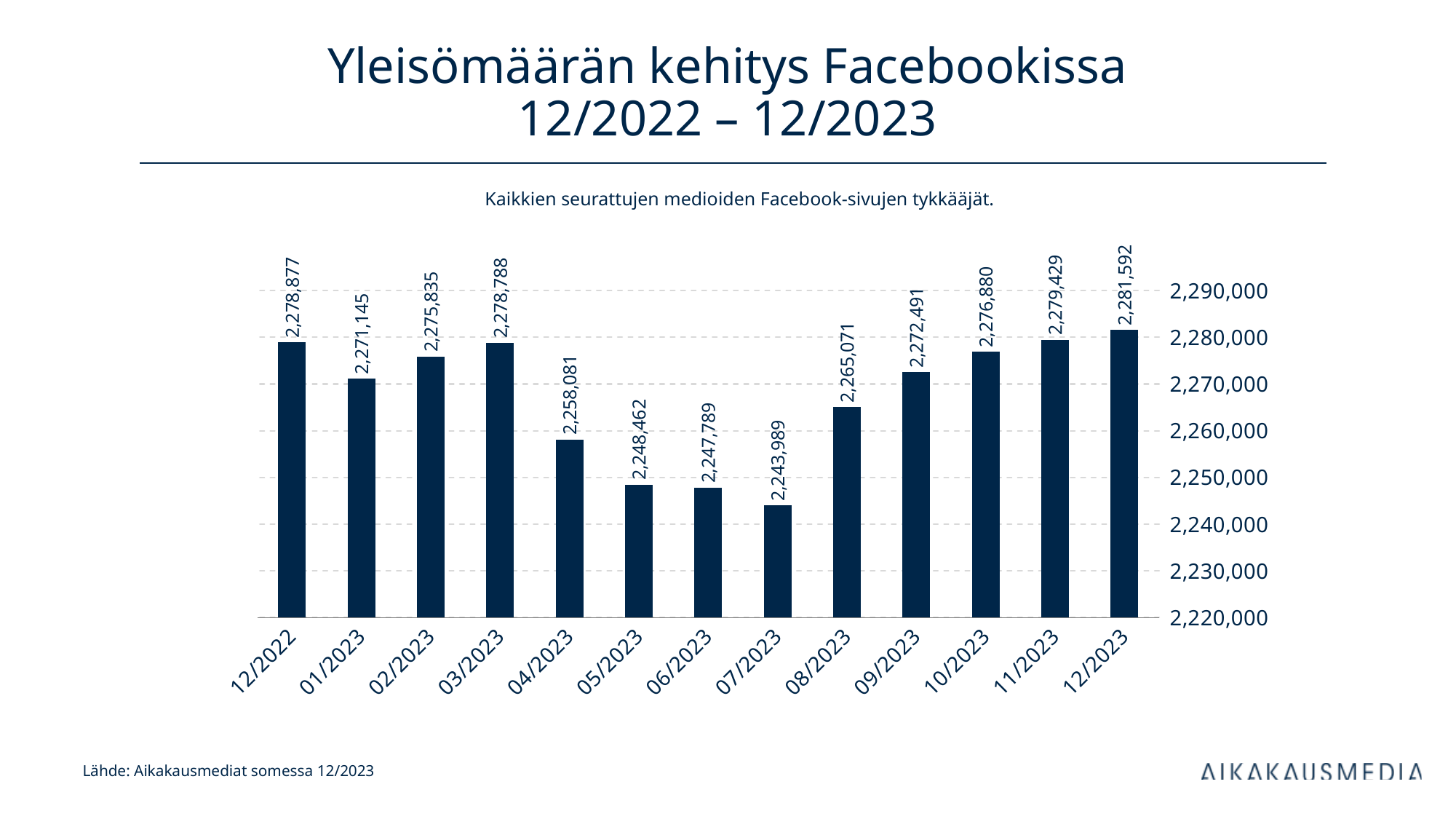
Which is larger, the value for 04/2023 or the value for 09/2023? 09/2023 Do the values rise or fall from 07/2023 to 12/2023? rise What is the difference between the values for 08/2023 and 07/2023? 21,082 What is the value for 12/2023? 2,281,592 What kind of chart is shown on the slide? bar chart What is the value for 07/2023? 2,243,989 What is the difference between the values for 12/2023 and 12/2022? 2,715 What is the value for 04/2023? 2,258,081 How many months are shown on the x axis? 13 Which month has the lowest value? 07/2023 Is the value for 07/2023 greater or less than 2,250,000? less Which month has the highest value? 12/2023